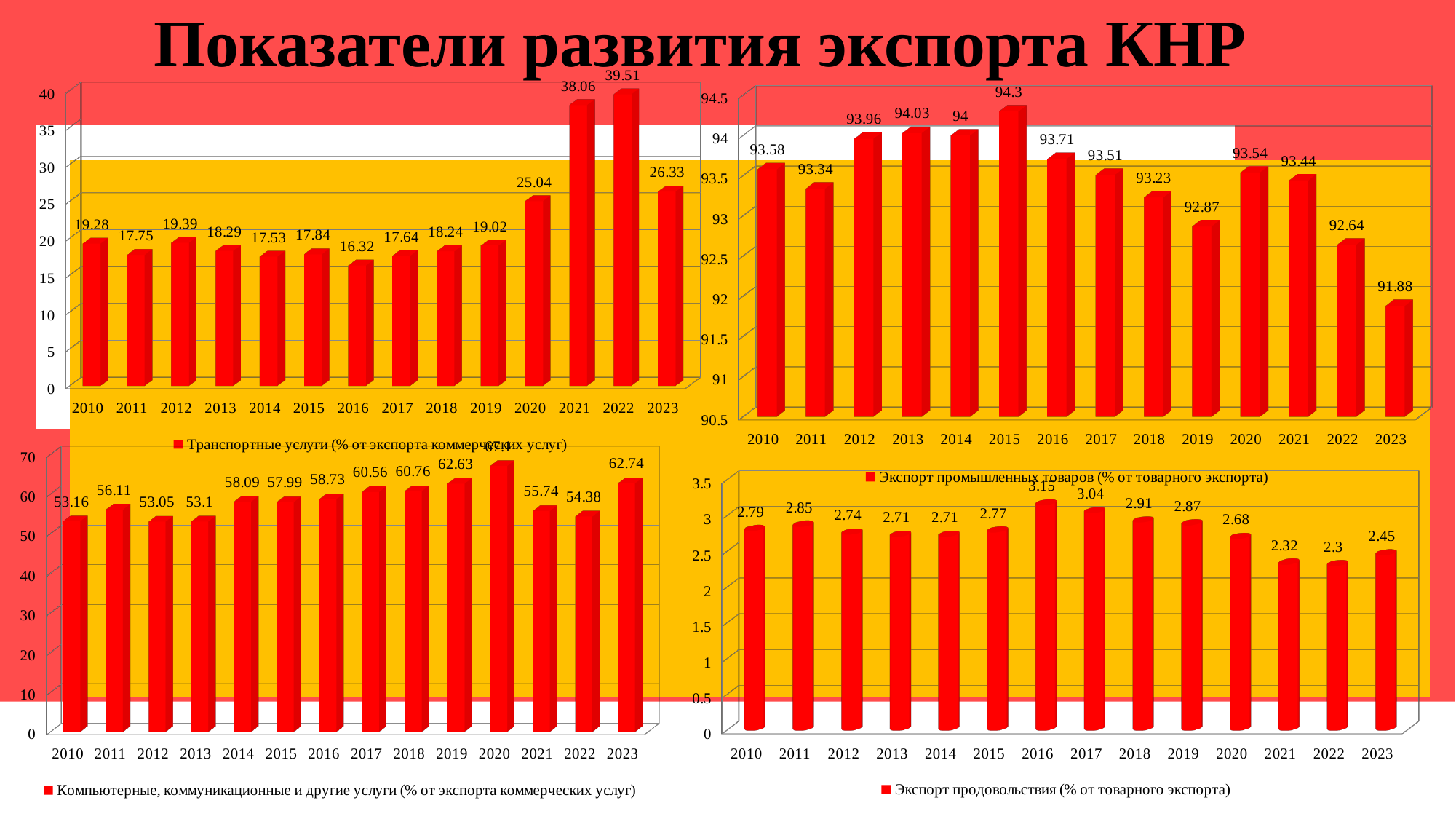
In the bottom-left chart (Компьютерные, коммуникационные и другие услуги), what is the value for 2020? 67.1 In the bottom-right chart (Экспорт продовольствия), which year has the highest value? 2016 In the top-right chart (Экспорт промышленных товаров), which year has the highest value? 2015 In the bottom-right chart (Экспорт продовольствия), what is the value for 2021? 2.32 In the top-left chart (Транспортные услуги), what is the difference between the 2021 and 2020 values? 13.02 In the bottom-left chart (Компьютерные, коммуникационные и другие услуги), what is the difference between the 2023 and 2022 values? 8.36 What type of chart is the bottom-right chart (Экспорт продовольствия)? Bar chart In the top-left chart (Транспортные услуги), what is the value for 2022? 39.51 In the top-right chart (Экспорт промышленных товаров), which is larger, the value for 2012 or the value for 2019? 2012 In the bottom-left chart (Компьютерные, коммуникационные и другие услуги), how many years are shown on the x axis? 14 In the top-right chart (Экспорт промышленных товаров), what is the value for 2023? 91.88 In the top-left chart (Транспортные услуги), which year has the lowest value? 2016